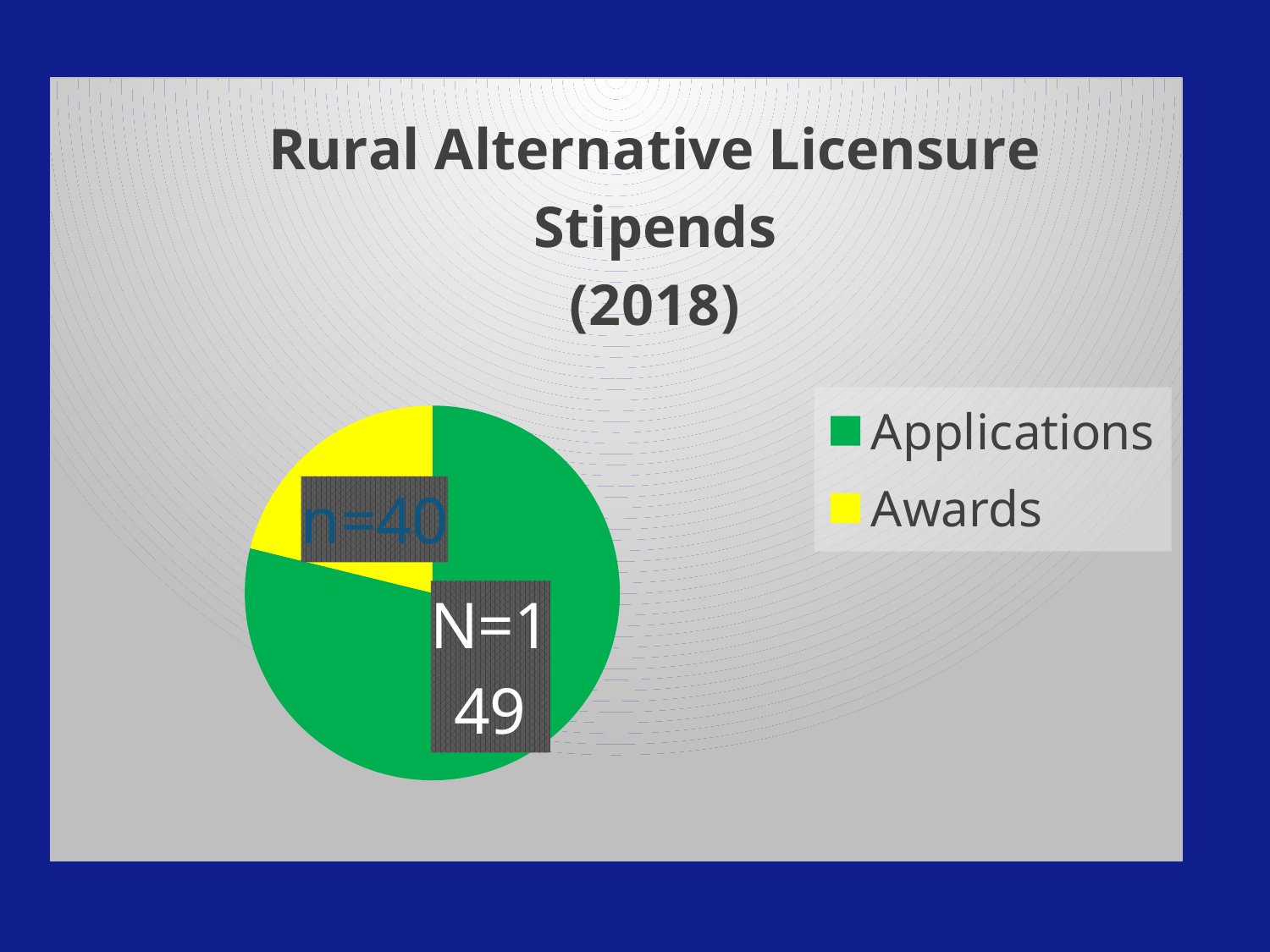
What is the total of the Applications and Awards values shown on the pie chart? 189 What value is labelled on the Applications slice of the pie chart? N=149 Which slice of the pie chart is the smallest? Awards What is the difference between the Applications value and the Awards value? 109 What colour represents Awards in the pie chart? Yellow How many slices does the pie chart have? 2 How many entries does the legend list? 2 What is the title of the chart? Rural Alternative Licensure Stipends (2018) What kind of chart is shown on the slide? Pie chart Which slice of the pie chart is the largest? Applications What value is labelled on the Awards slice of the pie chart? n=40 Which is larger, Applications or Awards? Applications